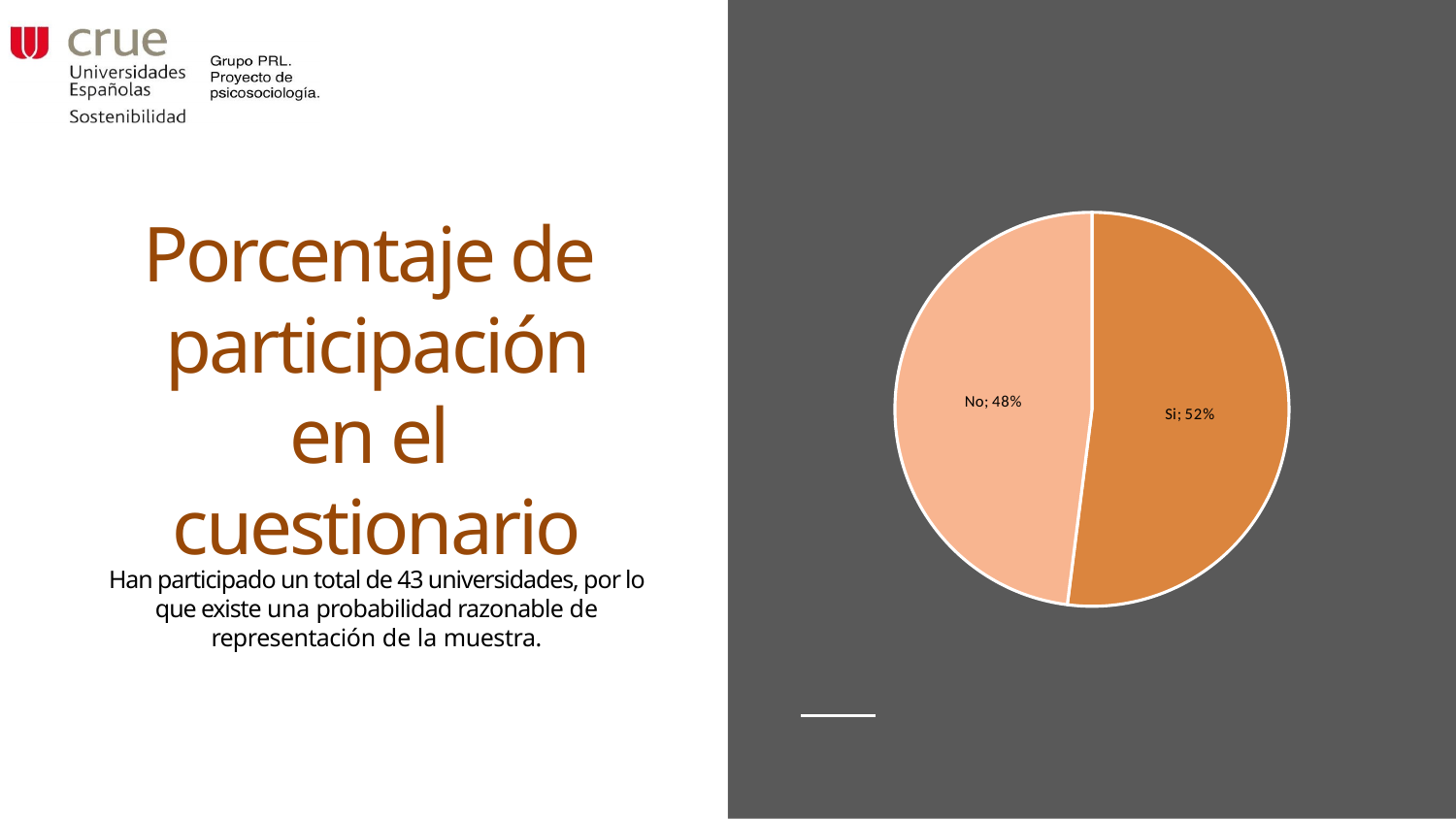
Which slice is the largest in the pie chart? Si What is the title given on the slide for the pie chart? Porcentaje de participación en el cuestionario How many slices does the pie chart have? 2 What share of the pie does the 'No' slice take? 48% Which is larger, the 'Si' slice or the 'No' slice? Si Is the value for 'Si' greater or less than 50%? greater What is the difference in percentage points between the 'Si' and 'No' slices? 4 Which slice is the smallest in the pie chart? No What percentage does the 'No' slice represent? 48% Which slice is drawn in the darker orange colour? Si What percentage does the 'Si' slice represent? 52% What kind of chart is shown on the slide? pie chart